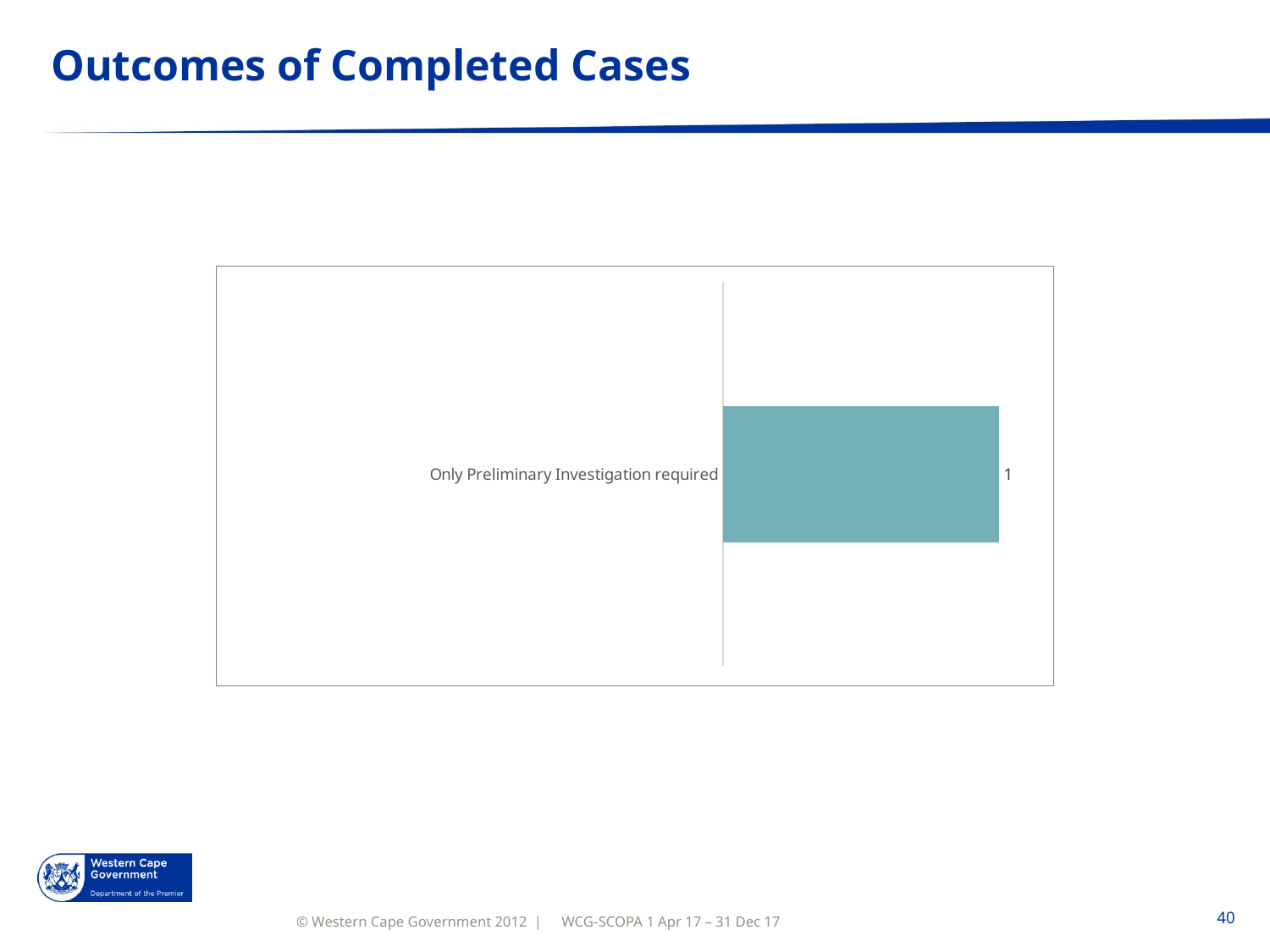
How many categories are plotted in the chart? 1 What is the title of the slide containing the chart? Outcomes of Completed Cases Which category has the highest value in the chart? Only Preliminary Investigation required What is the label of the only category shown in the chart? Only Preliminary Investigation required What is the value for 'Only Preliminary Investigation required'? 1 What kind of chart is shown on the slide? bar chart